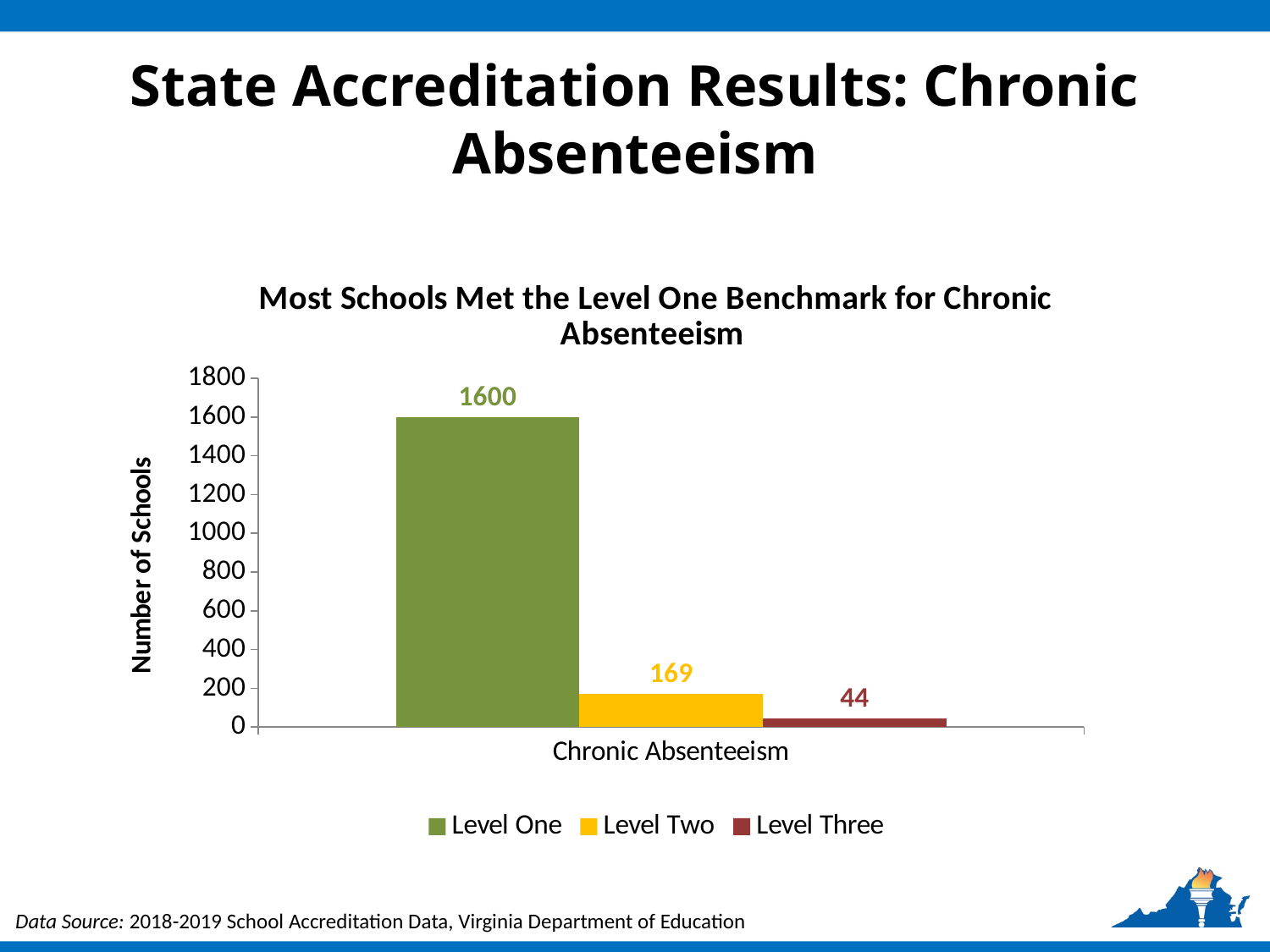
What is the title of the chart? Most Schools Met the Level One Benchmark for Chronic Absenteeism Which has more schools, Level Two or Level Three? Level Two What is the difference between the number of schools in Level One and Level Two? 1431 How many series does the legend list? 3 Is the value for Level Two greater or less than 200? less How many schools are in Level Two for Chronic Absenteeism? 169 What kind of chart is shown on the slide? bar chart How many schools are in Level Three for Chronic Absenteeism? 44 Which level has the highest number of schools? Level One Which level has the lowest number of schools? Level Three What is the difference between the number of schools in Level Two and Level Three? 125 How many schools are in Level One for Chronic Absenteeism? 1600